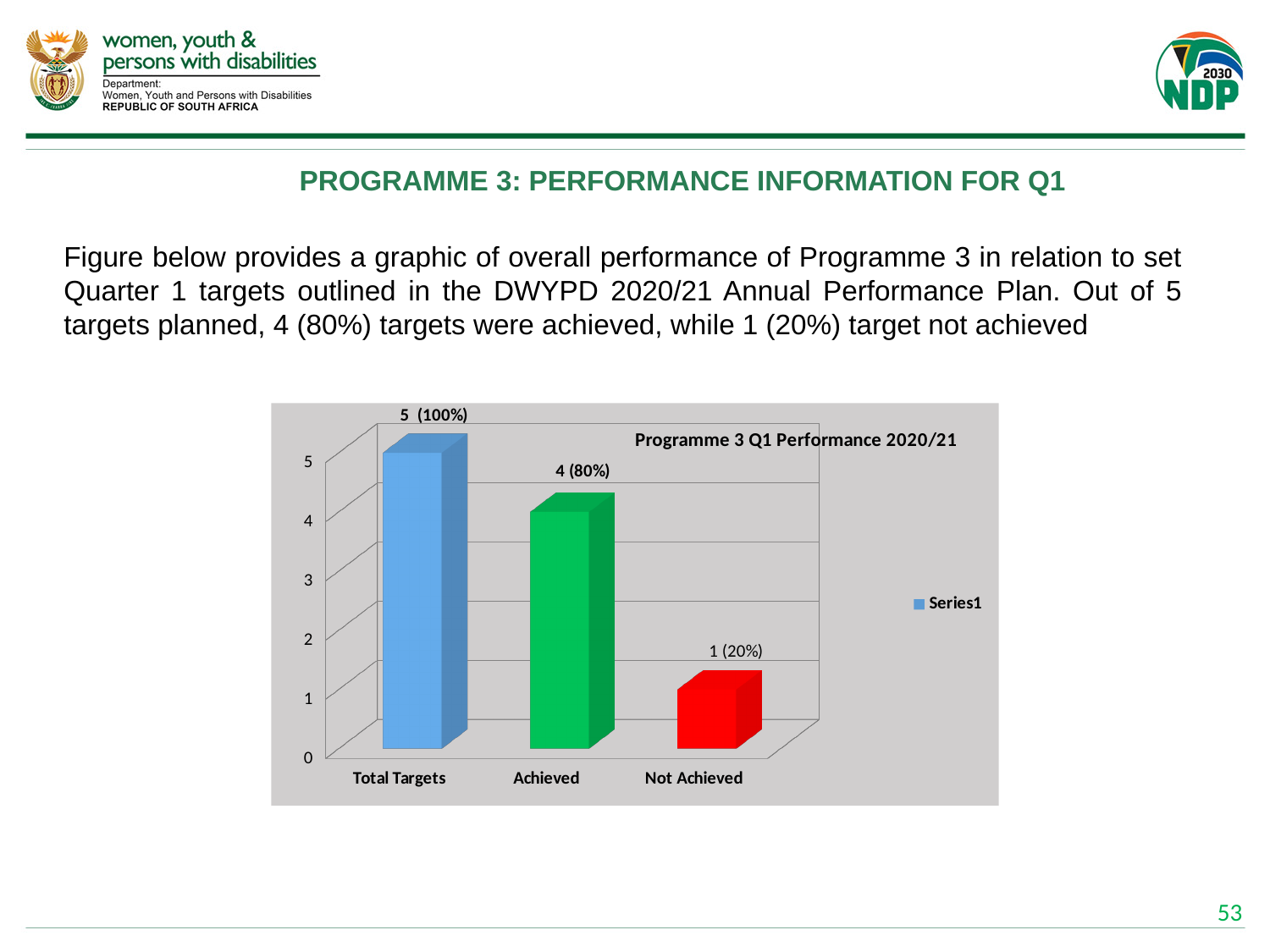
What is the data label shown for Total Targets? 5 (100%) Which category has the highest value? Total Targets What is the difference between the Achieved and Not Achieved values? 3 What is the data label shown for Achieved? 4 (80%) Is the value for Achieved greater or less than 3? greater Which category has the lowest value? Not Achieved How many categories are shown on the x axis? 3 How many series does the legend list? 1 What is the title of the chart? Programme 3 Q1 Performance 2020/21 What is the data label shown for Not Achieved? 1 (20%) Which is larger, the value for Achieved or the value for Not Achieved? Achieved What kind of chart is shown? bar chart